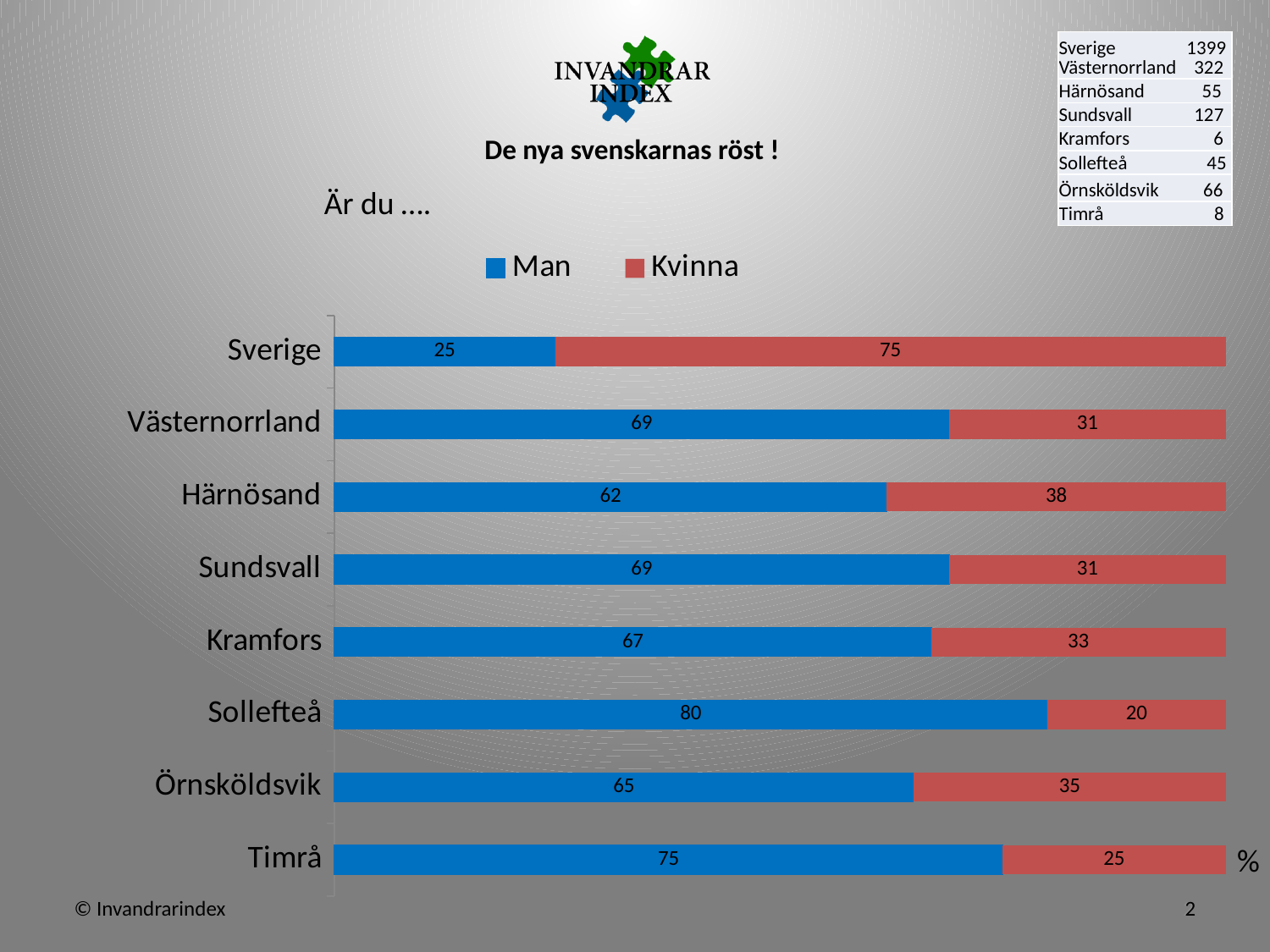
Which category has the lowest Man value? Sverige What is the difference between the Man and Kvinna values for Timrå? 50 What is the Kvinna value for Sollefteå? 20 How many categories are shown on the chart? 8 Which is larger, the Man value for Kramfors or the Man value for Örnsköldsvik? Kramfors What is the Man value for Härnösand? 62 What is the Man value for Sverige? 25 Which category has the highest Man value? Sollefteå What kind of chart is shown? Stacked bar chart What is the total of the stacked bar for Västernorrland? 100 How many series does the legend list? 2 What is the Kvinna value for Örnsköldsvik? 35